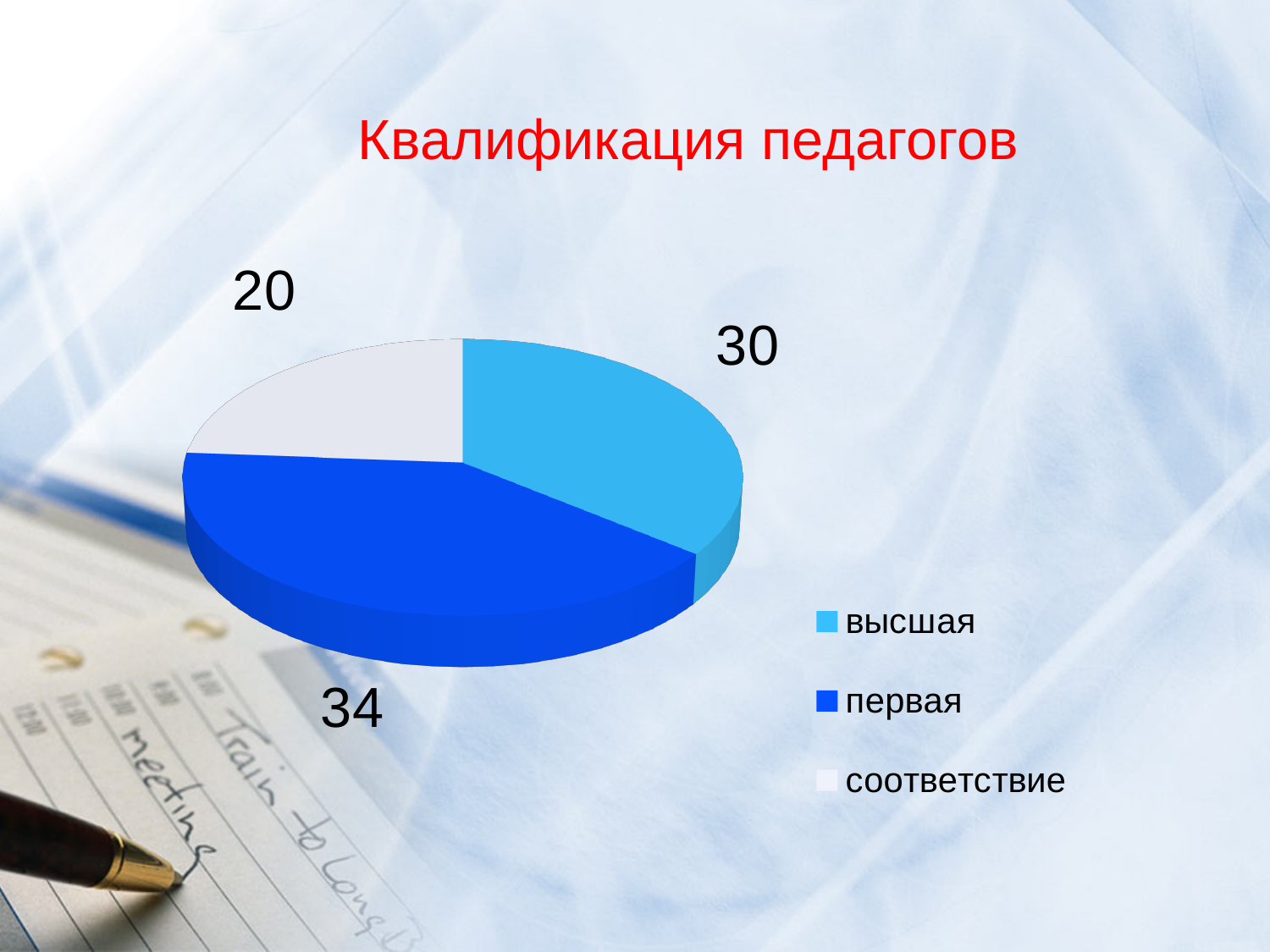
What is the value for первая? 34 Which category has the largest slice? первая What is the difference between the values for высшая and соответствие? 10 What type of chart is shown on the slide? pie chart What is the total of all slices in the pie? 84 What is the title of the chart? Квалификация педагогов Which category has the smallest slice? соответствие What is the difference between the values for первая and высшая? 4 What is the value for высшая? 30 Which is larger, the value for высшая or the value for соответствие? высшая What is the value for соответствие? 20 How many categories does the legend list? 3